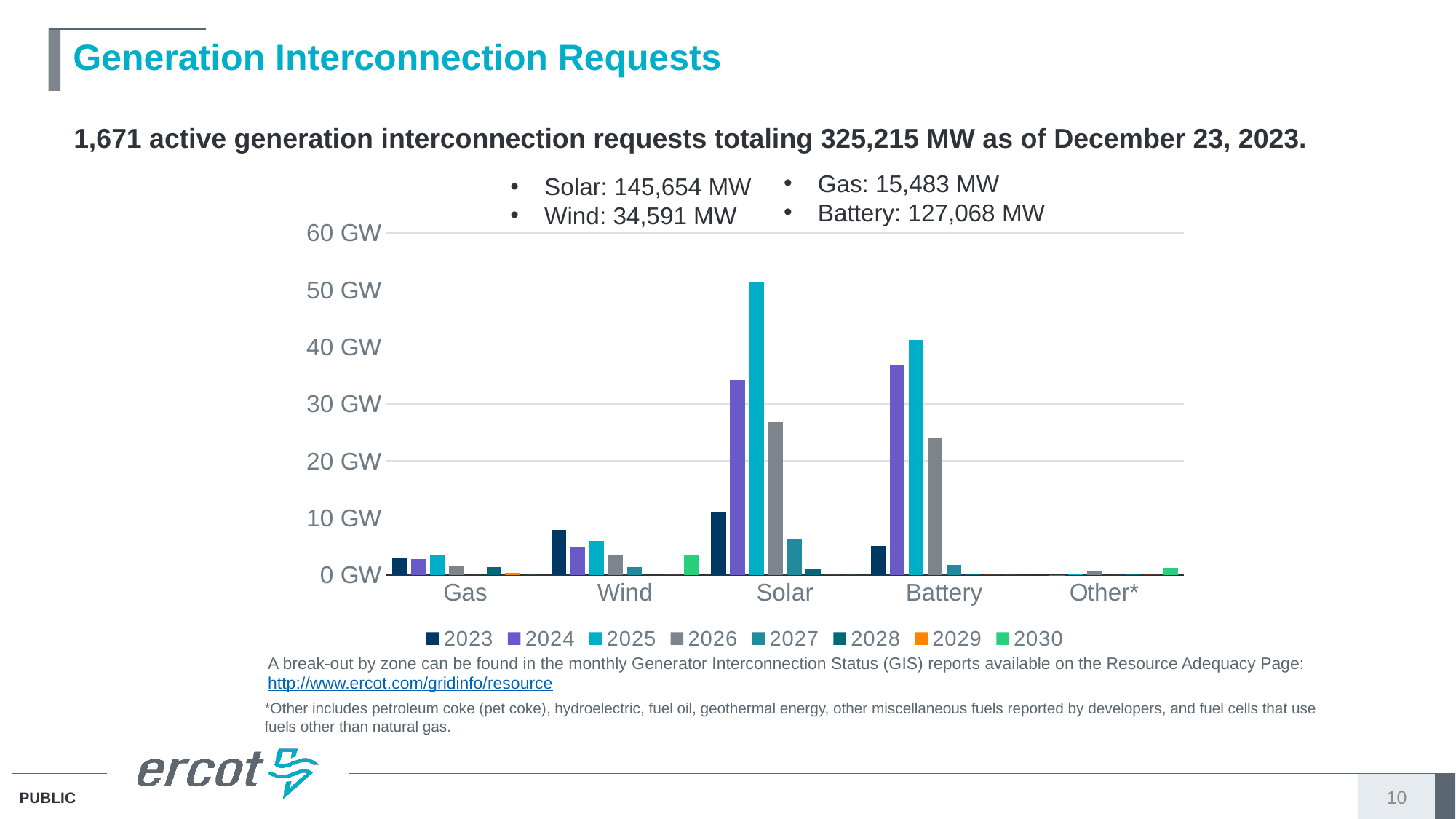
Is the 2023 bar for Wind greater or less than 10 GW? less Is the 2026 bar for Battery greater or less than 30 GW? less Which fuel category contains the tallest bar in the chart? Solar What colour does the legend use for the 2029 series? Orange For the Solar category, which year has the tallest bar? 2025 For the Battery category, which year has the tallest bar? 2025 How many fuel categories are shown on the x axis of the chart? 5 How many series (years) does the chart legend list? 8 Which is larger, the 2025 bar for Solar or the 2025 bar for Battery? Solar What kind of chart is shown on the slide? Bar chart Is the 2025 bar for Solar greater or less than 40 GW? greater